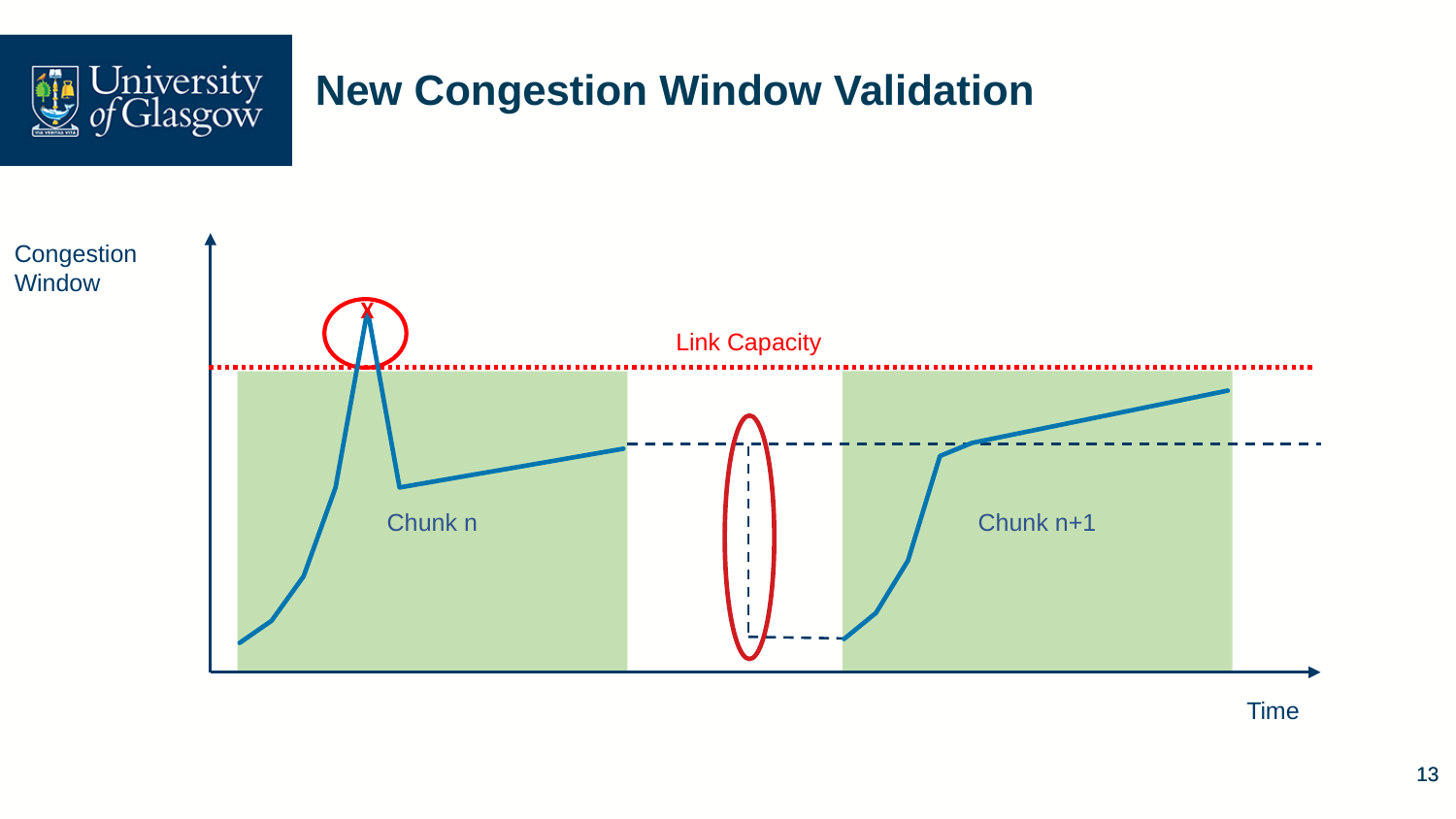
What are the labels of the two green shaded regions in the chart? Chunk n and Chunk n+1 Does the congestion window rise or fall in the gap between Chunk n and Chunk n+1? fall Which is higher at the end of its chunk: the congestion window at the end of Chunk n or at the end of Chunk n+1? end of Chunk n+1 Does the congestion window rise or fall over time within the Chunk n+1 region? rise What kind of chart is shown on the slide? line chart What is the label on the horizontal axis of the chart? Time Is the peak of the congestion window marked with the red X above or below the Link Capacity line? above How many green shaded chunk regions are shown in the chart? 2 What does the red dotted horizontal line in the chart represent? Link Capacity What quantity is plotted on the vertical axis of the chart? Congestion Window What is the title of the slide containing the chart? New Congestion Window Validation